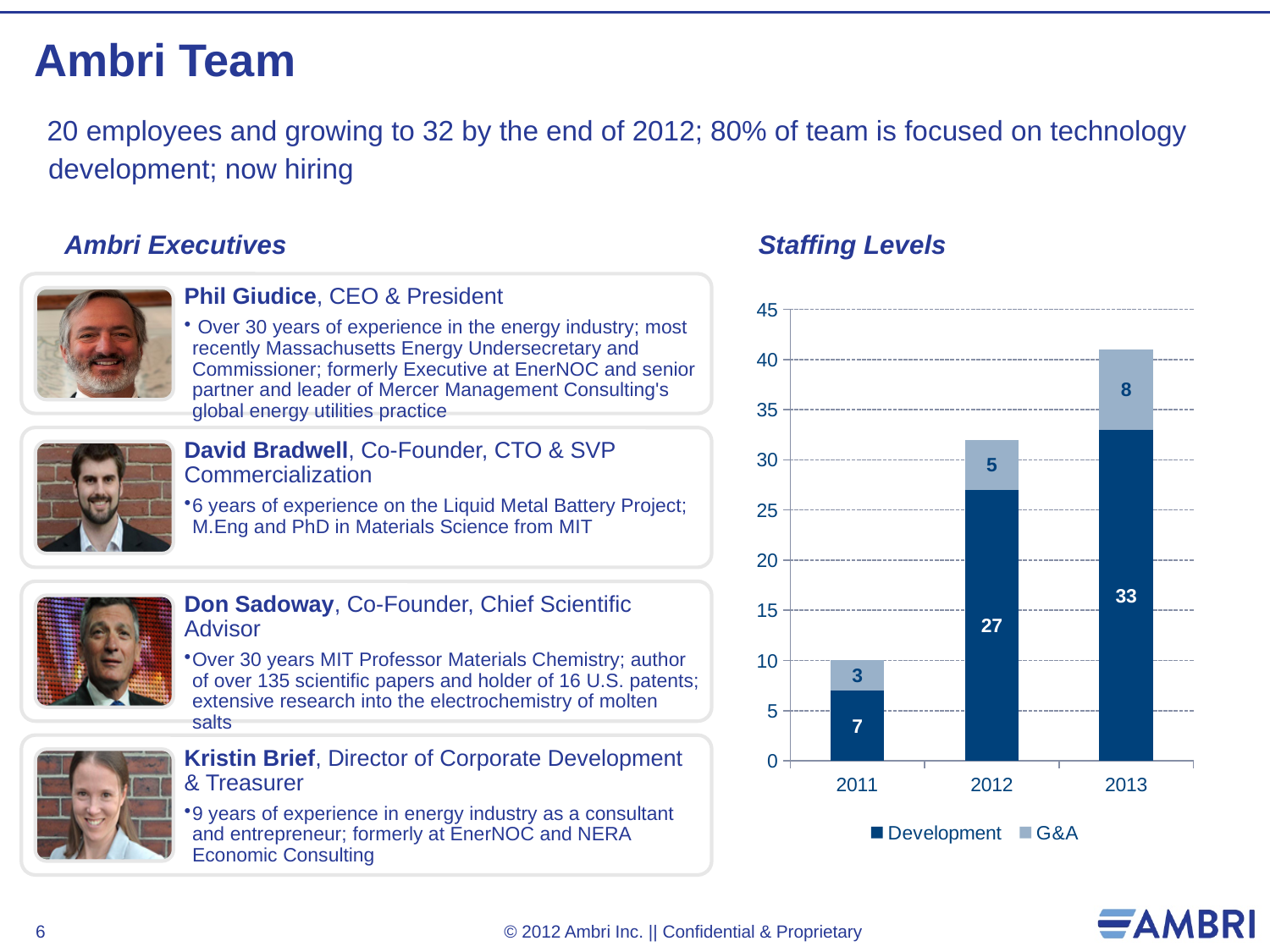
What is the Development value for 2011 in the Staffing Levels chart? 7 How many years are shown on the x axis of the Staffing Levels chart? 3 What is the G&A value for 2013 in the Staffing Levels chart? 8 Which year has the highest Development value in the Staffing Levels chart? 2013 What is the total staffing level for 2012 in the Staffing Levels chart? 32 What is the difference between the Development values for 2013 and 2012 in the Staffing Levels chart? 6 What kind of chart is the Staffing Levels chart? stacked bar chart Is the G&A value for 2012 larger or smaller than the G&A value for 2013 in the Staffing Levels chart? smaller How many series does the legend of the Staffing Levels chart list? 2 What is the total staffing level for 2013 in the Staffing Levels chart? 41 Which year has the lowest G&A value in the Staffing Levels chart? 2011 What is the Development value for 2012 in the Staffing Levels chart? 27